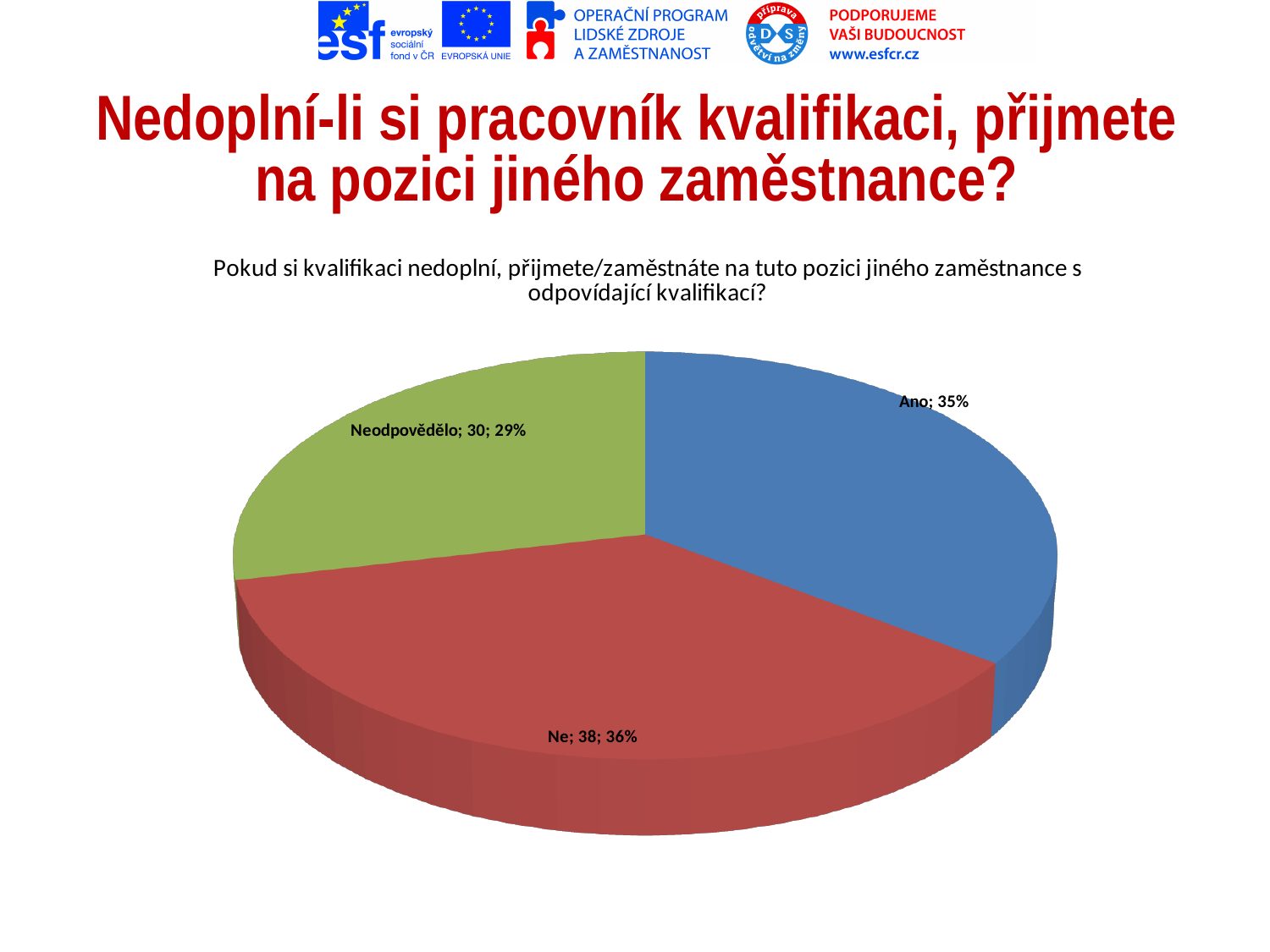
What type of chart is shown on the slide? Pie chart What percentage of the pie does the "Neodpovědělo" slice represent? 29% What count is shown for the "Ne" slice? 38 What percentage of the pie does the "Ano" slice represent? 35% What colour is the "Ne" slice? Red What is the difference between the counts for "Ne" and "Neodpovědělo"? 8 Which slice has the largest share of the pie? Ne Which slice has a larger share, "Ano" or "Neodpovědělo"? Ano Which slice has the smallest share of the pie? Neodpovědělo What percentage of the pie does the "Ne" slice represent? 36% What count is shown for the "Neodpovědělo" slice? 30 How many slices does the pie chart have? 3